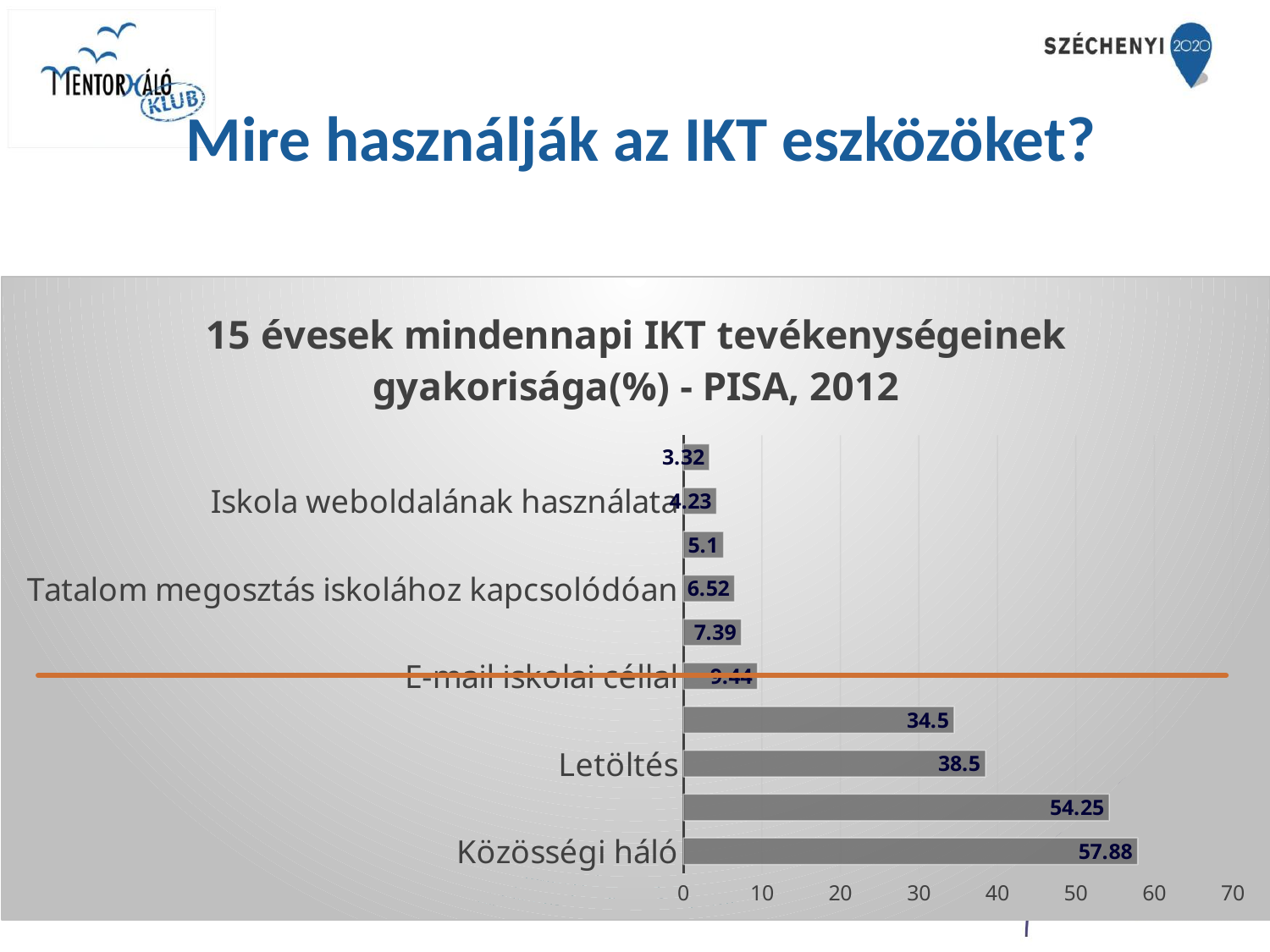
What is the difference between the values for Közösségi háló and Letöltés? 19.38 What kind of chart is shown? bar chart What is the title of the chart? 15 évesek mindennapi IKT tevékenységeinek gyakorisága(%) - PISA, 2012 What is the smallest value shown on the chart? 3.32 What is the value for Közösségi háló? 57.88 Which category has the highest value? Közösségi háló How many bars are plotted on the chart? 10 Is the value for Letöltés greater or less than 30? greater What is the value for Tatalom megosztás iskolához kapcsolódóan? 6.52 What is the value for Iskola weboldalának használata? 4.23 Which is larger, the value for Letöltés or the value for Iskola weboldalának használata? Letöltés What is the value for Letöltés? 38.5